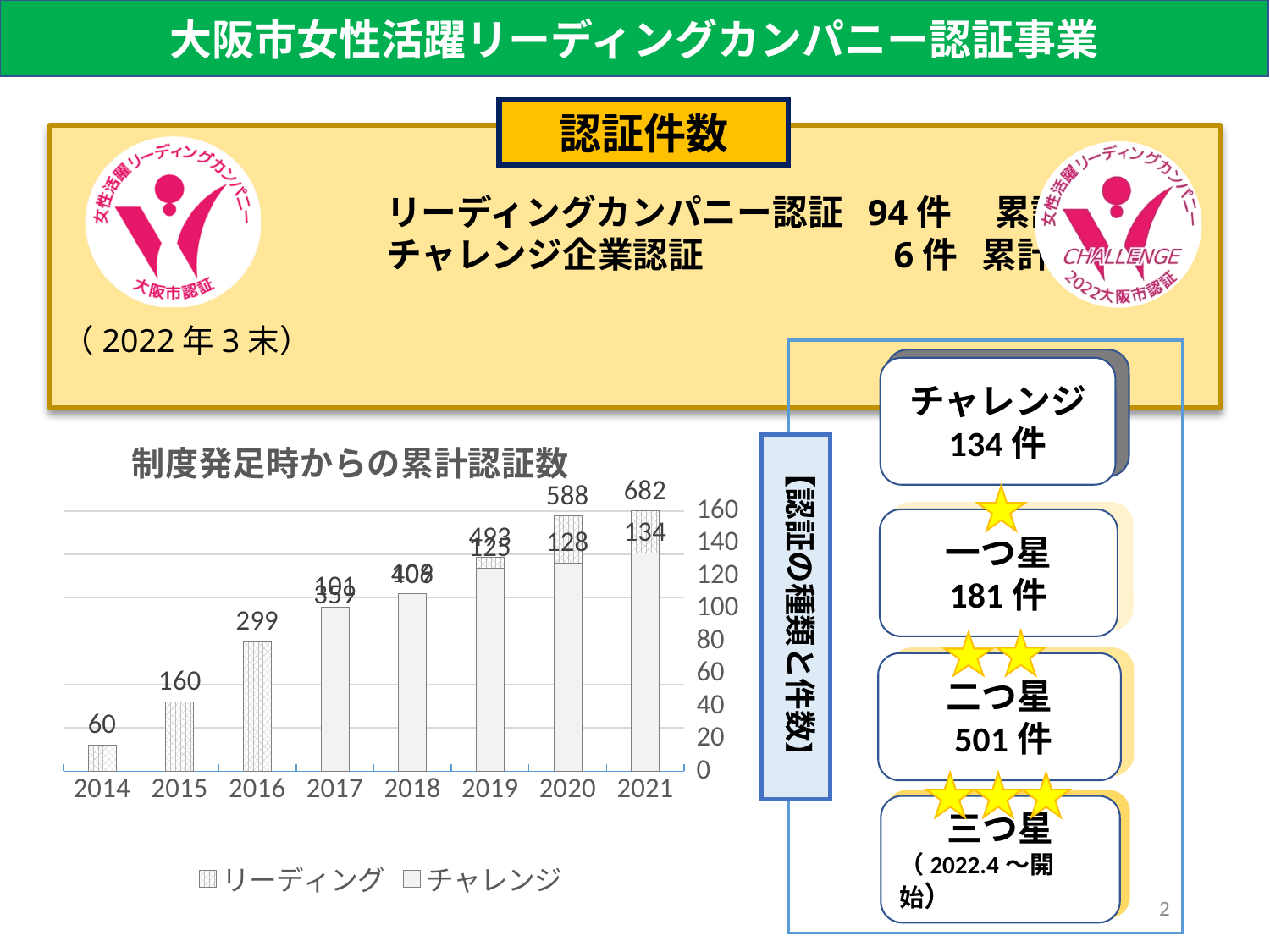
What is the chart's title? 制度発足時からの累計認証数 What is the リーディング value for 2014? 60 What is the リーディング value for 2021? 682 Which year has the lowest リーディング value? 2014 How many years are shown on the x axis of the chart? 8 What is the リーディング value for 2016? 299 What is the difference between the リーディング values for 2021 and 2020? 94 What kind of chart is shown on the slide? bar chart What is the チャレンジ value for 2021? 134 How many series does the legend list? 2 Which year has the highest リーディング value? 2021 Do the リーディング values rise or fall from 2014 to 2021? rise